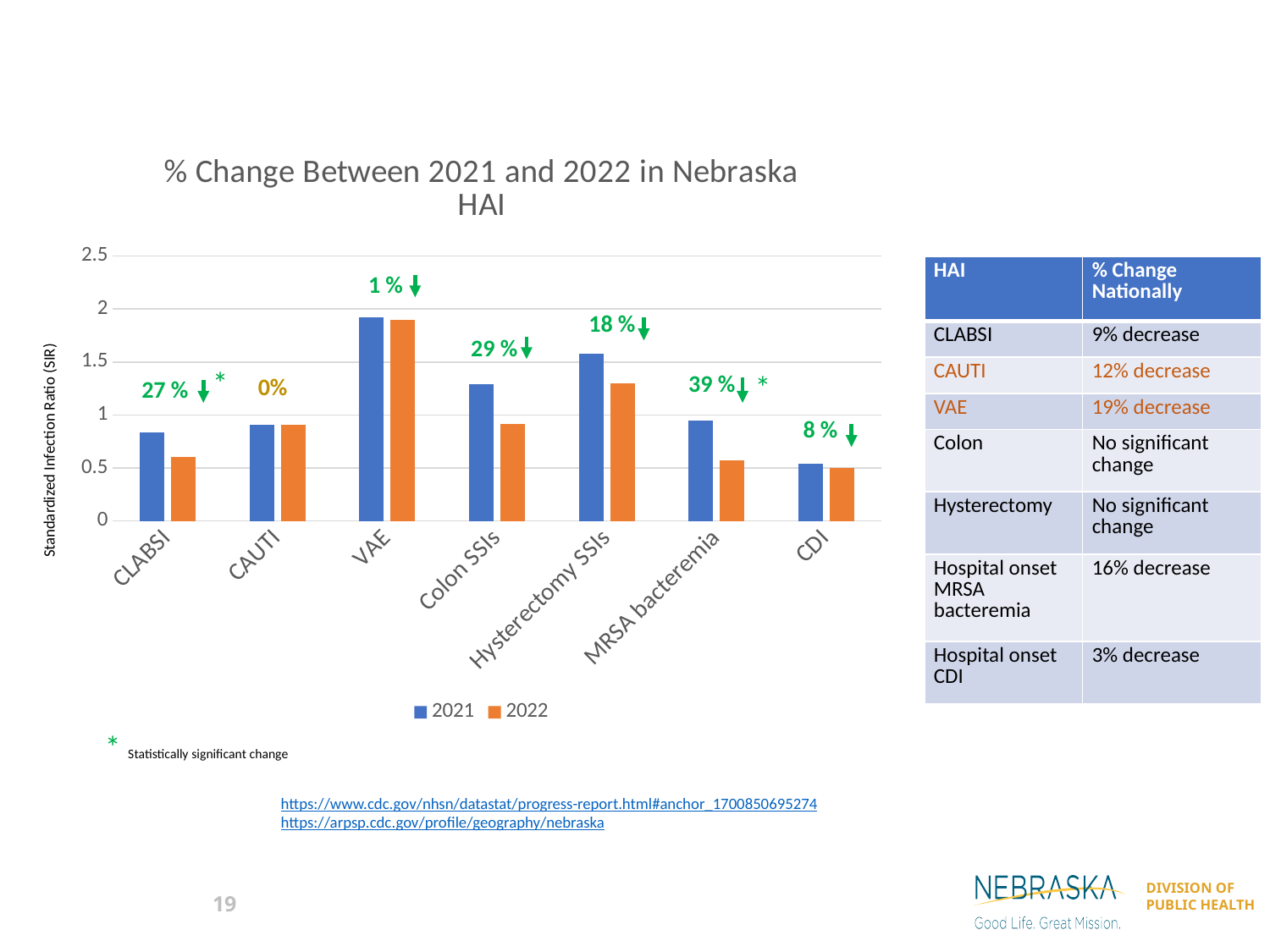
What percent change is annotated above the CAUTI bars in the chart? 0% How many series does the chart legend list? 2 Which HAI category has the highest 2021 Standardized Infection Ratio in the chart? VAE Which is larger in 2021: the value for VAE or the value for Colon SSIs? VAE How many HAI categories are plotted on the x axis of the chart? 7 What percent change is annotated above the MRSA bacteremia bars in the chart? 39 % Is the 2021 value for VAE greater or less than 1.5? greater Which HAI category has the lowest 2021 Standardized Infection Ratio in the chart? CDI What kind of chart is shown on the slide? bar chart Is the 2022 value for Colon SSIs greater or less than 1? less What is the title of the chart? % Change Between 2021 and 2022 in Nebraska HAI Is the 2021 value for CLABSI greater or less than 1? less